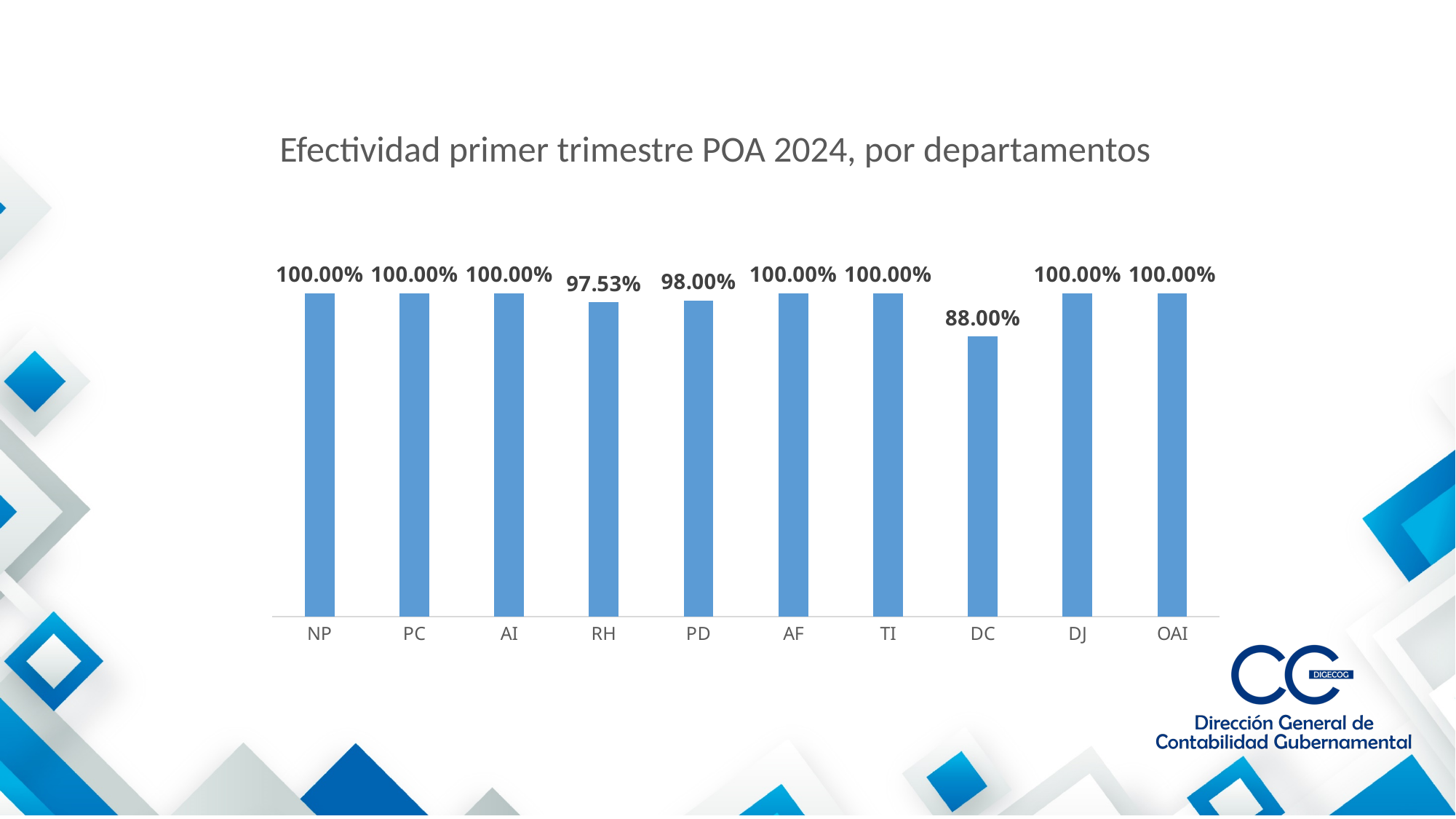
What is the difference between the values for AI and RH? 2.47% What is the difference between the values for PD and DC? 10.00% What kind of chart is shown? Bar chart What is the title of the chart? Efectividad primer trimestre POA 2024, por departamentos What is the value for DC? 88.00% What is the value for NP? 100.00% How many departments are shown on the x axis? 10 What is the value for RH? 97.53% Which department has the lowest value? DC Which is larger, the value for DC or the value for DJ? DJ Which is larger, the value for RH or the value for PD? PD What is the value for PD? 98.00%